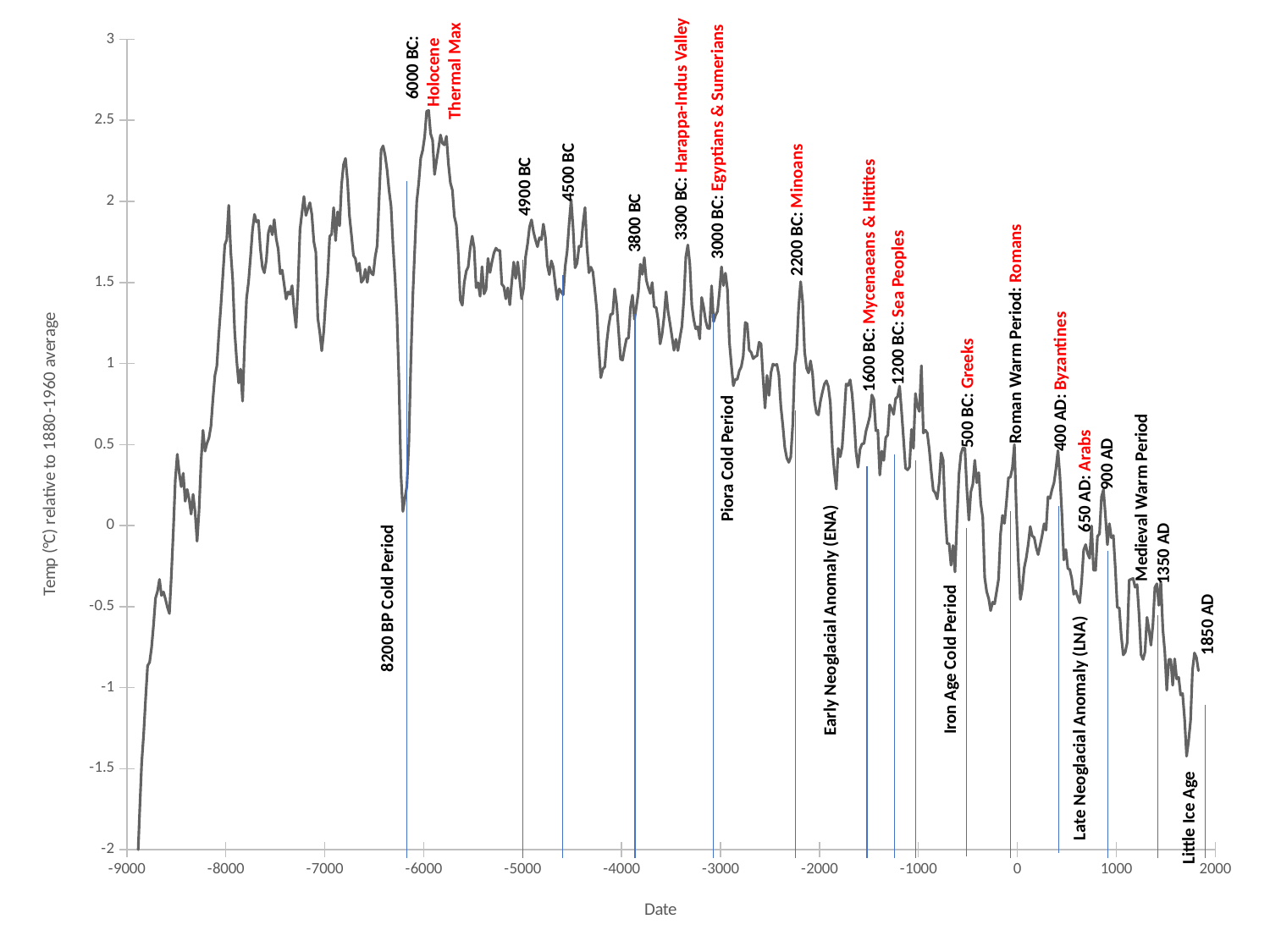
Is the temperature at 1850 AD greater or less than 0? less What is the title of the horizontal axis? Date Is the lowest temperature during the Little Ice Age greater or less than -1? less What is the title of the vertical axis? Temp (°C) relative to 1880-1960 average What kind of chart is shown on the slide? line chart Is the temperature at 500 BC (Greeks) greater or less than 1? less Which annotated event marks the highest temperature on the chart? 6000 BC: Holocene Thermal Max Do temperatures generally rise or fall from 6000 BC to 1850 AD? fall